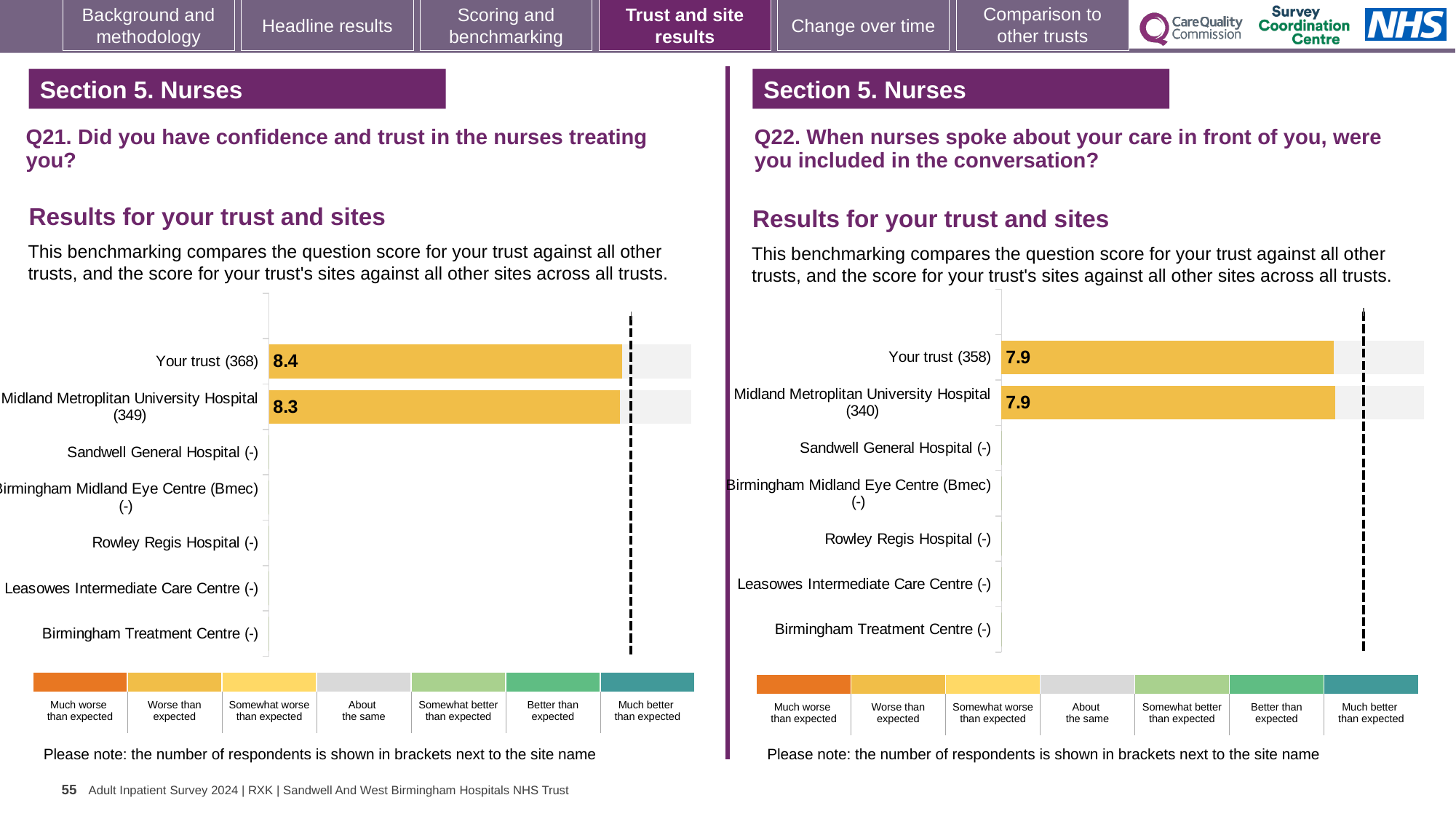
On the Q21 chart (left), what is the difference between the score for Your trust and the score for Midland Metroplitan University Hospital? 0.1 On the Q21 chart (left), what is the score for Midland Metroplitan University Hospital? 8.3 On the Q21 chart (left), how many respondents are shown in brackets for Your trust? 368 What kind of chart is used on the Q21 chart (left)? Bar chart On the Q22 chart (right), how many respondents are shown in brackets for Midland Metroplitan University Hospital? 340 On the Q22 chart (right), how many site or trust categories are listed on the vertical axis? 7 On the Q22 chart (right), what is the score for Your trust? 7.9 On the Q21 chart (left), what is the score for Your trust? 8.4 On the Q22 chart (right), what is the score for Midland Metroplitan University Hospital? 7.9 On the Q21 chart (left), how many categories have a plotted bar? 2 How many categories does the colour key below the Q21 chart (left) list? 7